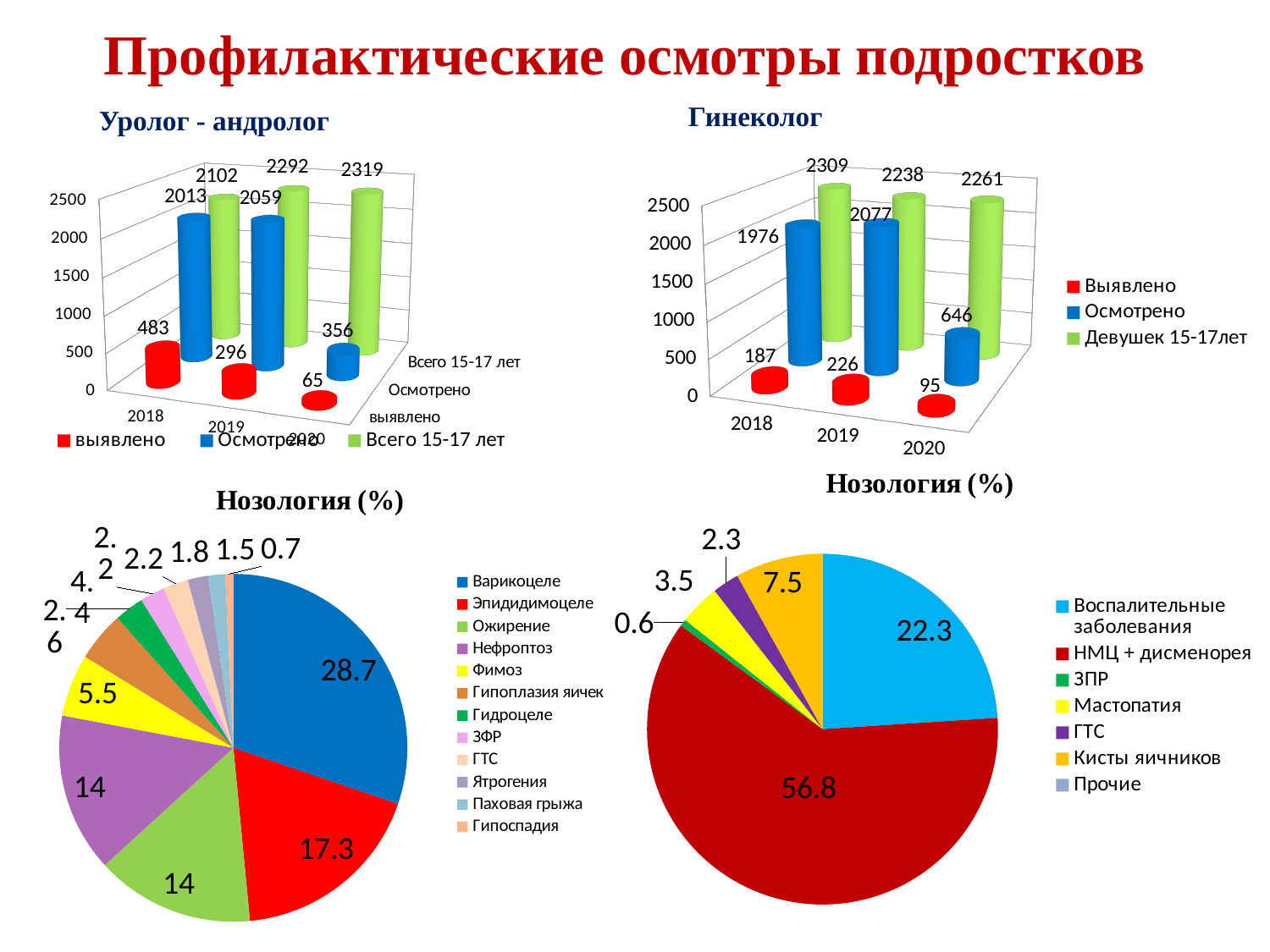
In the 'Гинеколог' bar chart, what is the value of 'Выявлено' for 2020? 95 In the 'Уролог - андролог' bar chart, what is the value of 'выявлено' for 2018? 483 In the 'Гинеколог' bar chart, which year has the lowest value for 'Осмотрено'? 2020 In the 'Гинеколог' bar chart, what is the difference between 'Осмотрено' in 2019 and in 2018? 101 How many series does the legend of the 'Уролог - андролог' bar chart list? 3 How many entries does the legend of the bottom-right 'Нозология (%)' pie chart list? 7 In the 'Гинеколог' bar chart, what is the value of 'Девушек 15-17лет' for 2018? 2309 In the 'Уролог - андролог' bar chart, which year has the highest value for 'Всего 15-17 лет'? 2020 In the bottom-left 'Нозология (%)' pie chart, what is the share of 'Варикоцеле'? 28.7 In the bottom-right 'Нозология (%)' pie chart, which category has the largest slice? НМЦ + дисменорея In the bottom-left 'Нозология (%)' pie chart, what is the difference between the 'Варикоцеле' and 'Эпидидимоцеле' shares? 11.4 In the 'Уролог - андролог' bar chart, what is the value of 'Осмотрено' for 2020? 356